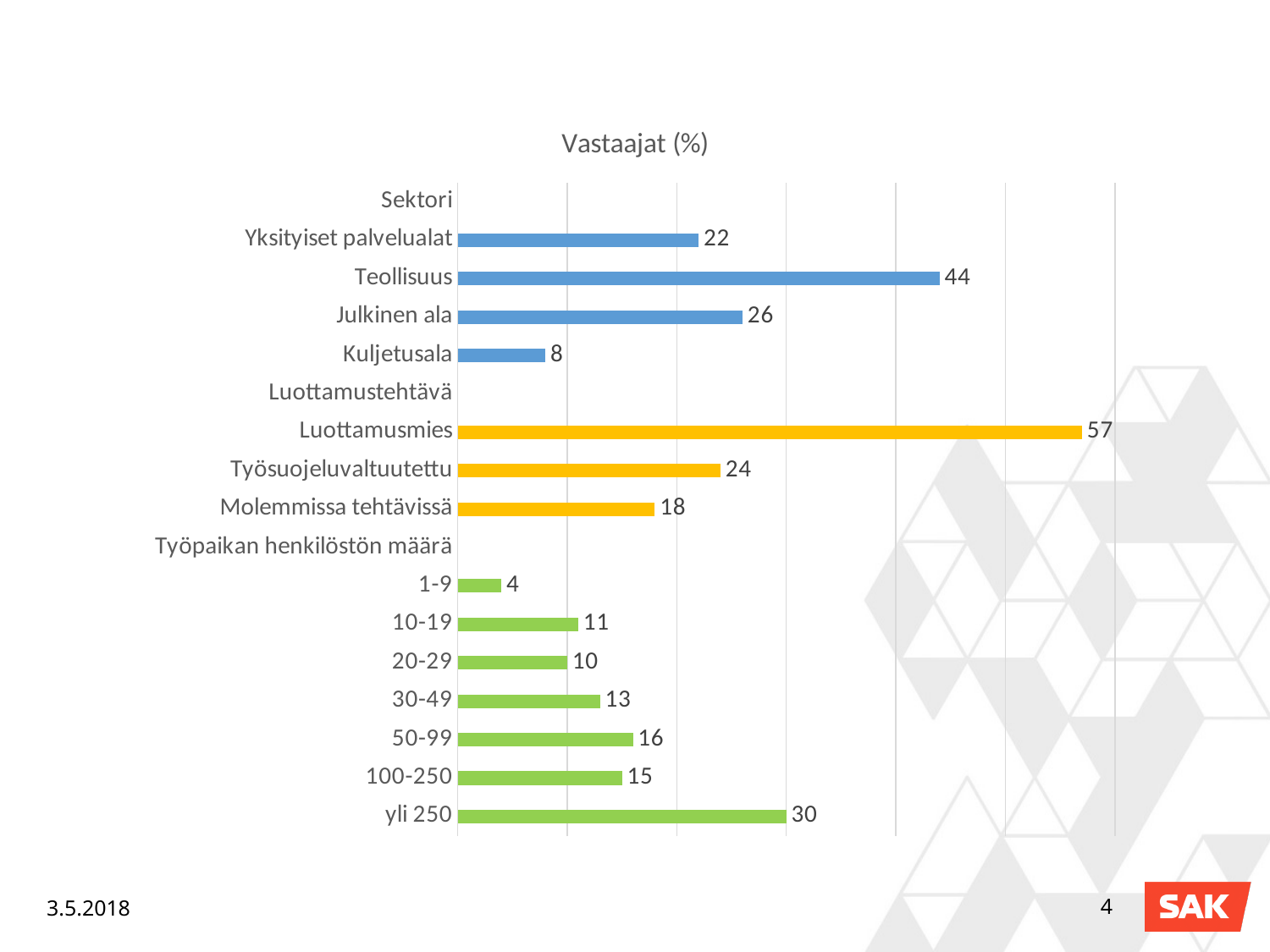
What kind of chart is shown on the slide? Bar chart What is the value for Luottamusmies? 57 What is the value for Teollisuus? 44 Which is larger, the value for Julkinen ala or the value for Yksityiset palvelualat? Julkinen ala What is the difference between the values for Teollisuus and Kuljetusala? 36 What is the title of the chart? Vastaajat (%) What is the difference between the values for Luottamusmies and Työsuojeluvaltuutettu? 33 What is the value for the 1-9 category? 4 Which category has the lowest value in the chart? 1-9 What is the value for yli 250? 30 How many bars are plotted in the chart? 14 Which category has the highest value in the chart? Luottamusmies